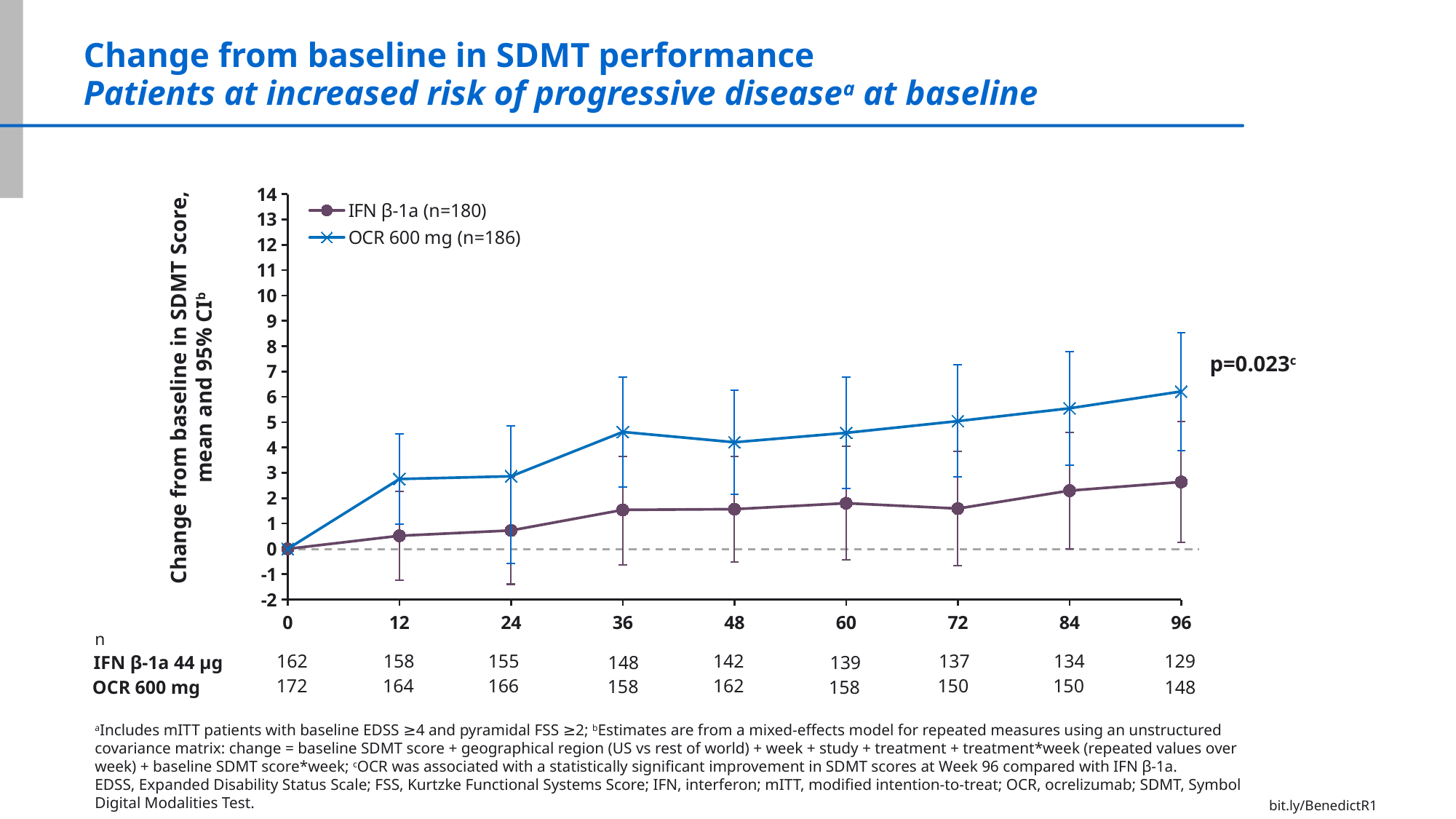
How many time points are plotted along the x axis? 9 Is the value for OCR 600 mg at week 96 greater or less than 5? greater How many series does the legend list? 2 What p-value is printed next to the chart? p=0.023 Is the value for IFN β-1a at week 96 greater or less than 2? greater Is the value for IFN β-1a at week 12 greater or less than 1? less At which week does the OCR 600 mg series reach its highest value? 96 What kind of chart is shown on the slide? line chart What is the n for OCR 600 mg at week 96 in the table below the chart? 148 At week 96, which series has the larger change from baseline in SDMT score, IFN β-1a or OCR 600 mg? OCR 600 mg Overall, does the OCR 600 mg series rise or fall from week 0 to week 96? rise